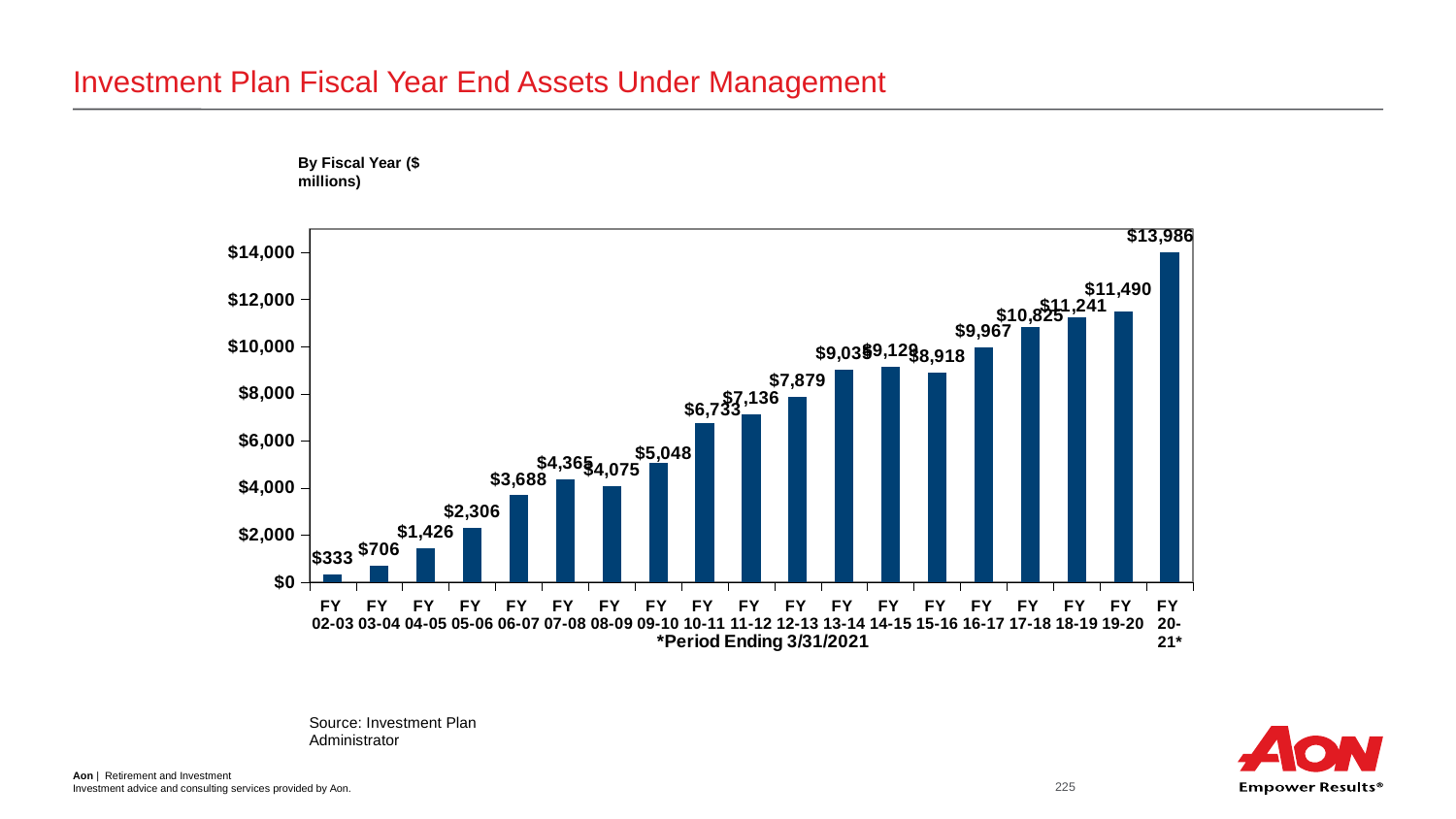
Which fiscal year has the highest assets under management? FY 20-21* What is the difference between the values for FY 19-20 and FY 18-19? $249 What is the value for FY 20-21*? $13,986 Which fiscal year has the lowest assets under management? FY 02-03 What is the difference between the values for FY 20-21* and FY 19-20? $2,496 In what units are the values on the chart expressed? $ millions What kind of chart is shown on the slide? bar chart How many fiscal years are shown on the chart? 19 What is the value for FY 15-16? $8,918 What is the value for FY 02-03? $333 Which is larger, the value for FY 07-08 or FY 08-09? FY 07-08 Is the value for FY 10-11 greater or less than $6,000? greater